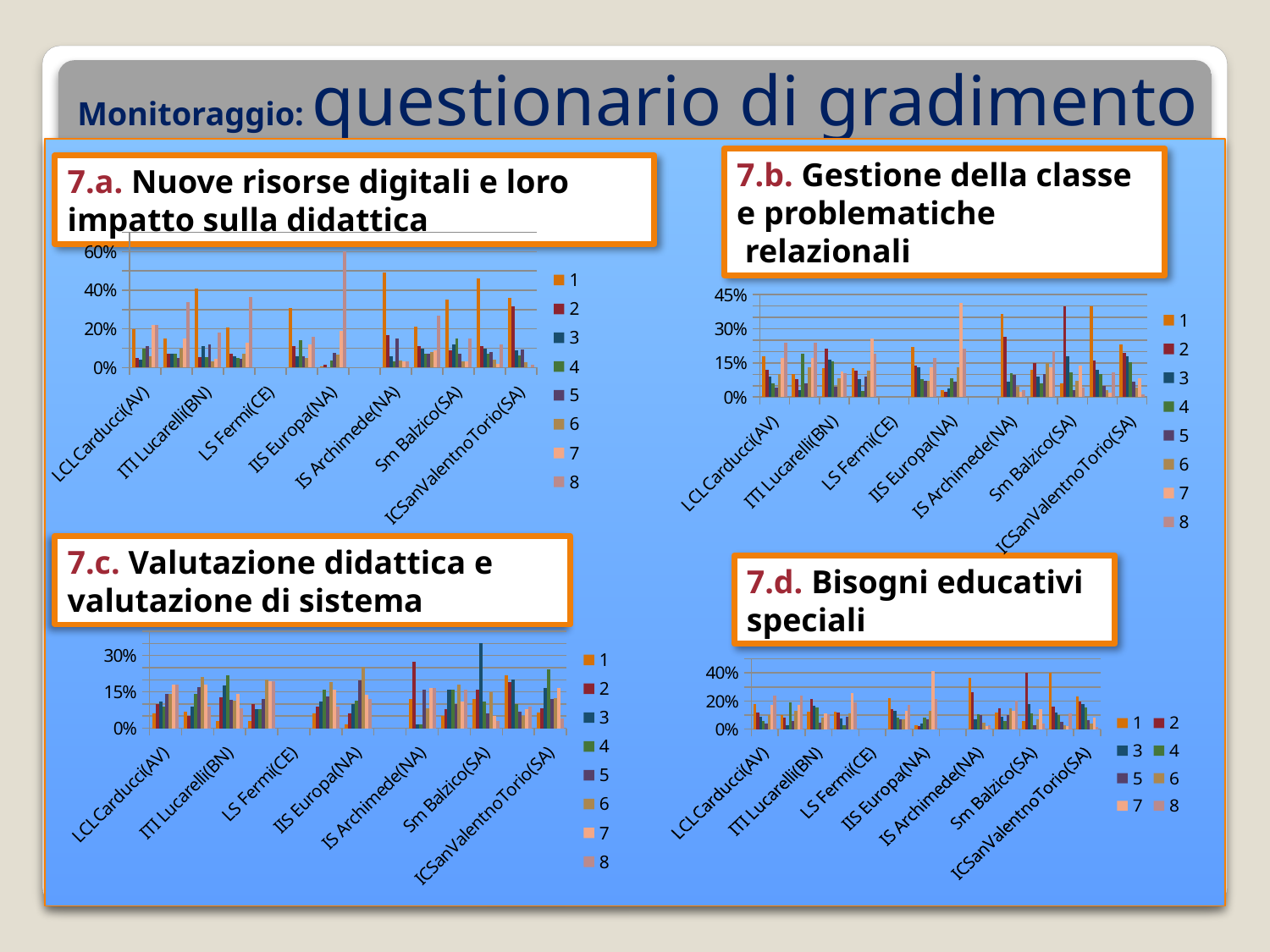
In chart 7.c. Valutazione didattica e valutazione di sistema, is the tallest bar for Sm Balzico(SA) greater or less than 15%? greater How many series does the legend of chart 7.c. Valutazione didattica e valutazione di sistema list? 8 What is the highest value shown on the y axis of chart 7.b. Gestione della classe e problematiche relazionali? 45% In chart 7.d. Bisogni educativi speciali, is the tallest bar for IIS Europa(NA) greater or less than 20%? greater How many series does the legend of chart 7.d. Bisogni educativi speciali list? 8 What kind of chart is used for 7.c. Valutazione didattica e valutazione di sistema? bar chart In chart 7.a. Nuove risorse digitali e loro impatto sulla didattica, is the tallest bar for IIS Europa(NA) greater or less than 40%? greater What is the label of the first category on the x axis of chart 7.a. Nuove risorse digitali e loro impatto sulla didattica? LCLCarducci(AV) What kind of chart is used for 7.a. Nuove risorse digitali e loro impatto sulla didattica? bar chart